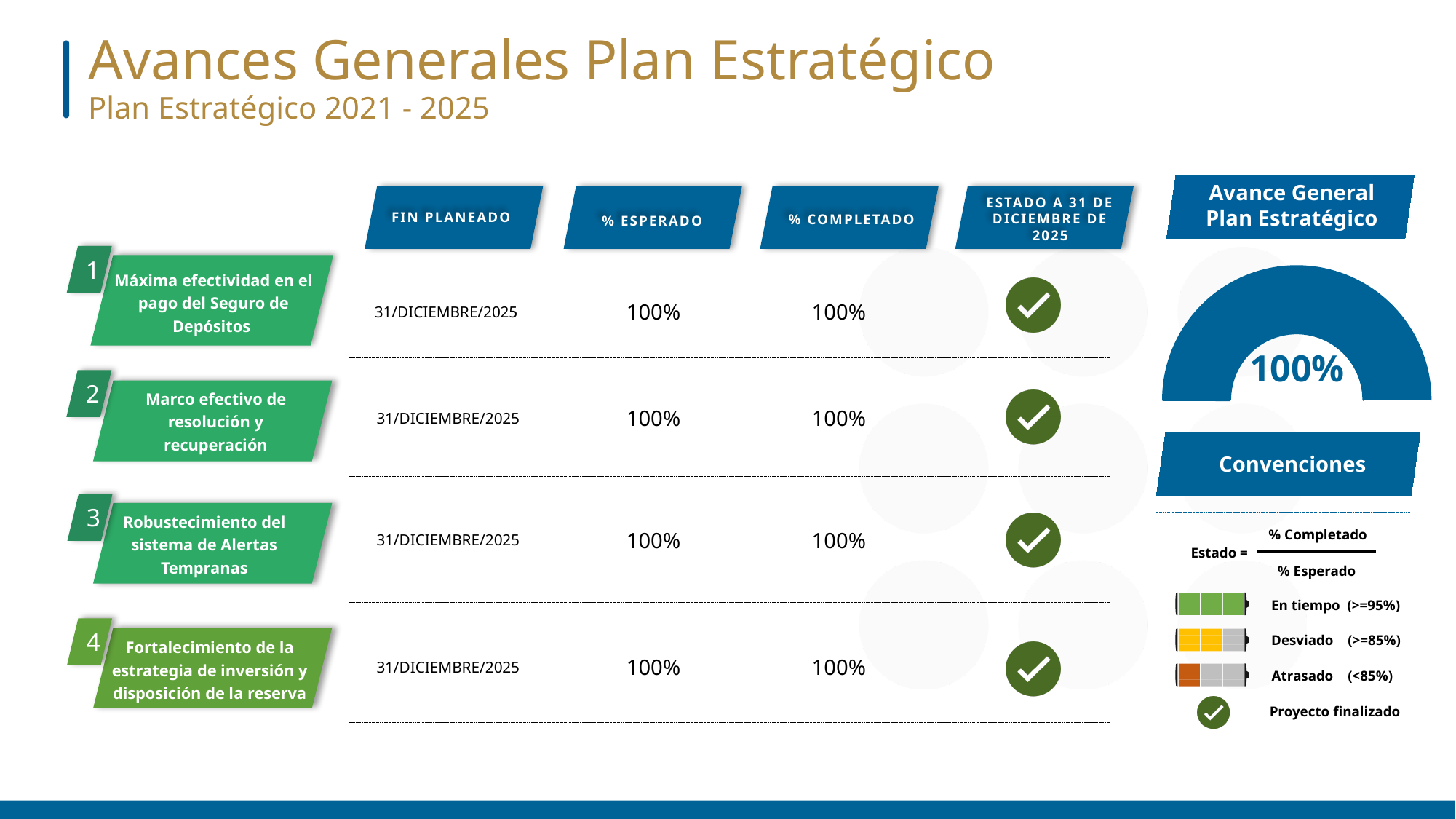
According to the 'Avance General Plan Estratégico' gauge, what share of the strategic plan has been completed? 100% What colour is the filled arc of the 'Avance General Plan Estratégico' gauge chart? Blue What is the title of the gauge chart on the right side of the slide? Avance General Plan Estratégico How many data values are displayed on the 'Avance General Plan Estratégico' gauge chart? 1 Is the value shown on the 'Avance General Plan Estratégico' gauge greater or less than 50%? greater What kind of chart is used to show the 'Avance General Plan Estratégico'? Gauge (semicircular doughnut) chart What value is shown in the centre of the 'Avance General Plan Estratégico' gauge chart? 100%